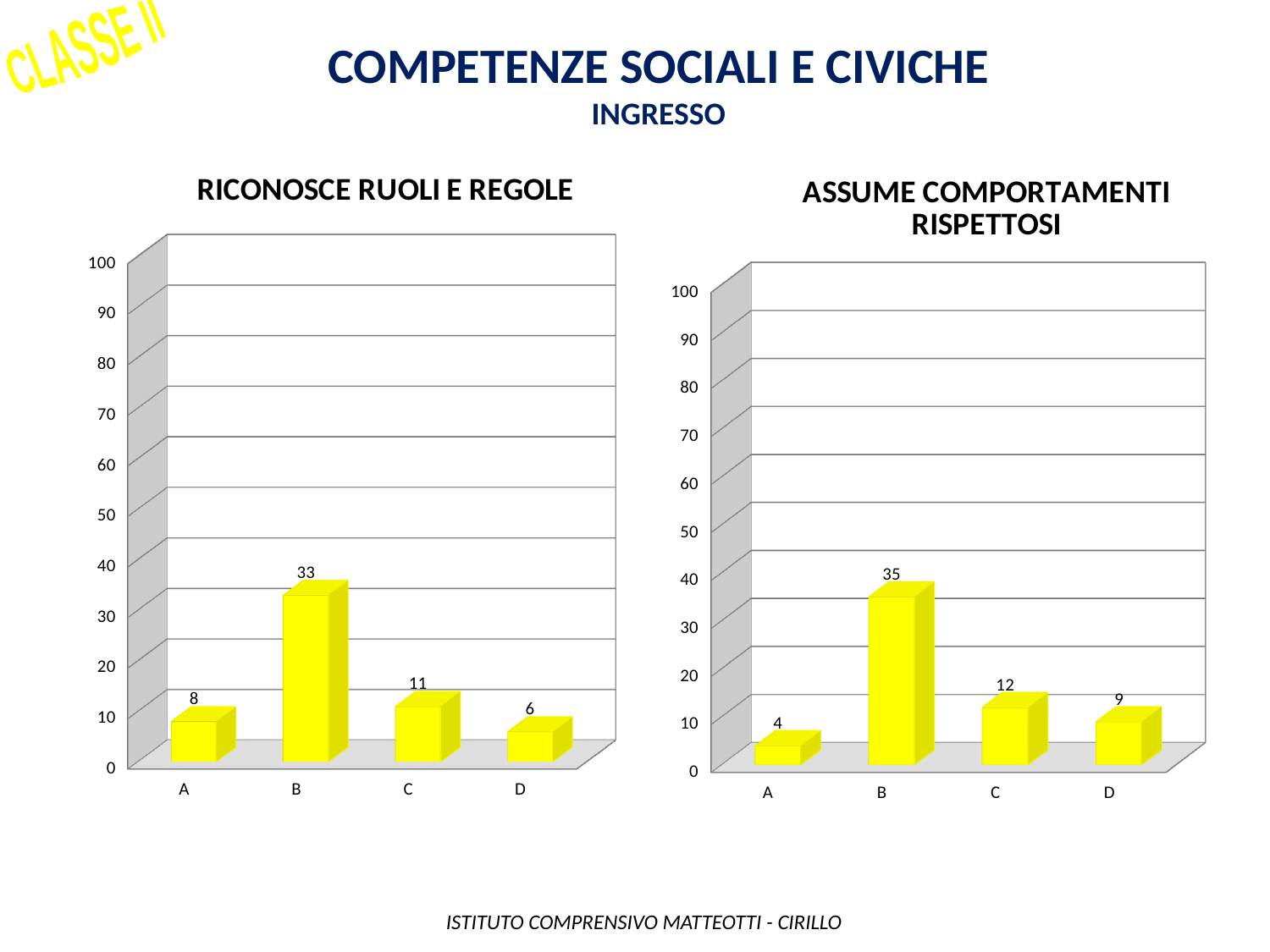
What is the title of the chart on the right side of the slide? ASSUME COMPORTAMENTI RISPETTOSI In the 'ASSUME COMPORTAMENTI RISPETTOSI' chart, is the value for B greater or less than 30? greater In the 'ASSUME COMPORTAMENTI RISPETTOSI' chart, what is the difference between the values for C and D? 3 In the 'RICONOSCE RUOLI E REGOLE' chart, what is the value for category B? 33 In the 'RICONOSCE RUOLI E REGOLE' chart, which is larger, the value for A or the value for C? C In the 'RICONOSCE RUOLI E REGOLE' chart, which category has the lowest value? D How many categories are shown in the 'RICONOSCE RUOLI E REGOLE' chart? 4 In the 'RICONOSCE RUOLI E REGOLE' chart, what is the value for category D? 6 In the 'RICONOSCE RUOLI E REGOLE' chart, what is the difference between the values for B and C? 22 In the 'ASSUME COMPORTAMENTI RISPETTOSI' chart, which category has the highest value? B What kind of chart is the 'ASSUME COMPORTAMENTI RISPETTOSI' chart? Bar chart In the 'ASSUME COMPORTAMENTI RISPETTOSI' chart, what is the value for category A? 4